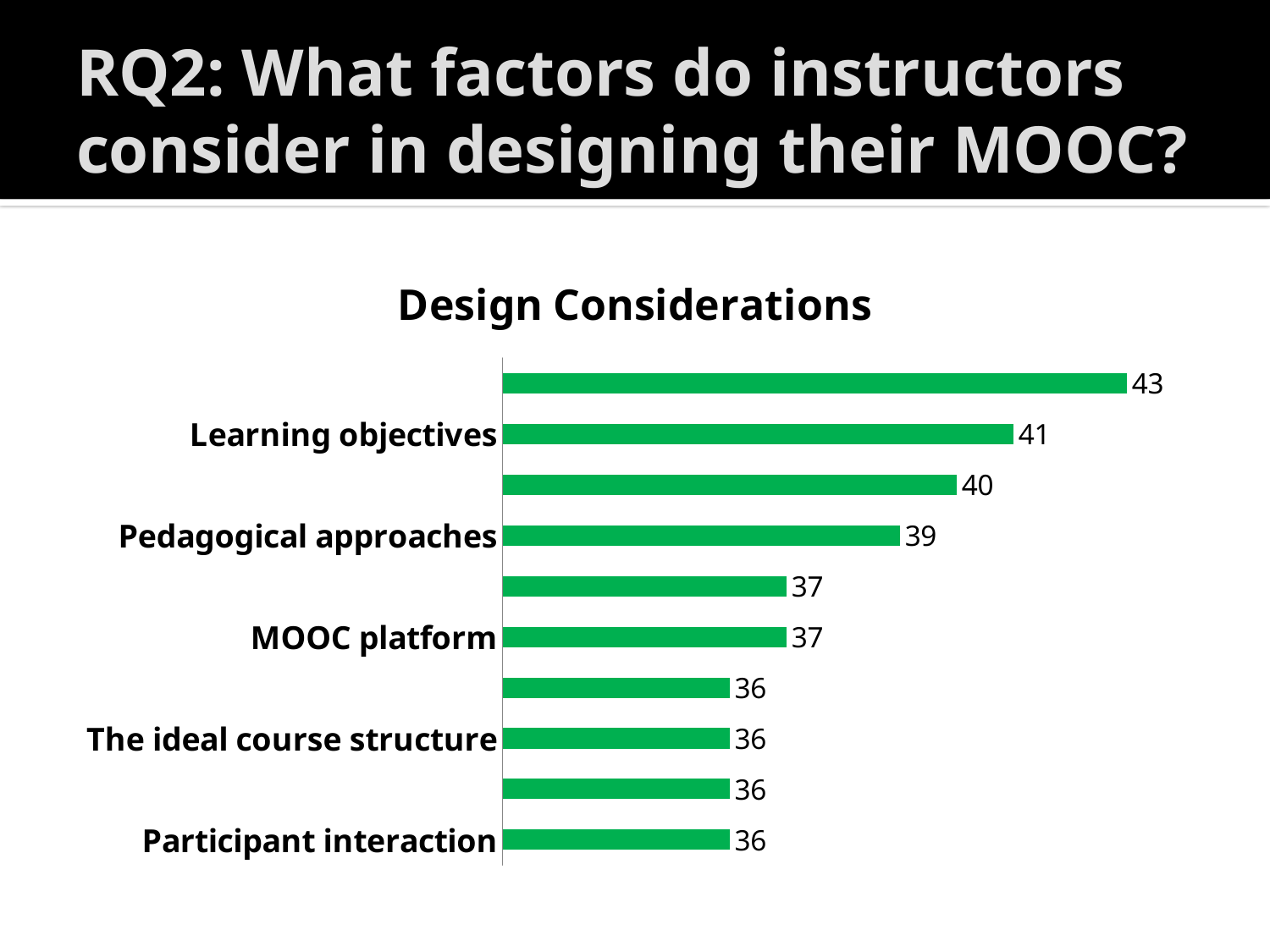
What is the value for The ideal course structure? 36 What is the largest value shown on the chart? 43 What is the difference between the values for Learning objectives and MOOC platform? 4 What is the value for Pedagogical approaches? 39 What is the value for Learning objectives? 41 What is the difference between the values for Learning objectives and Pedagogical approaches? 2 What is the value for MOOC platform? 37 What kind of chart is shown on the slide? Bar chart How many bars are plotted on the chart? 10 What is the value for Participant interaction? 36 Which has a larger value, Pedagogical approaches or MOOC platform? Pedagogical approaches What is the title of the chart? Design Considerations